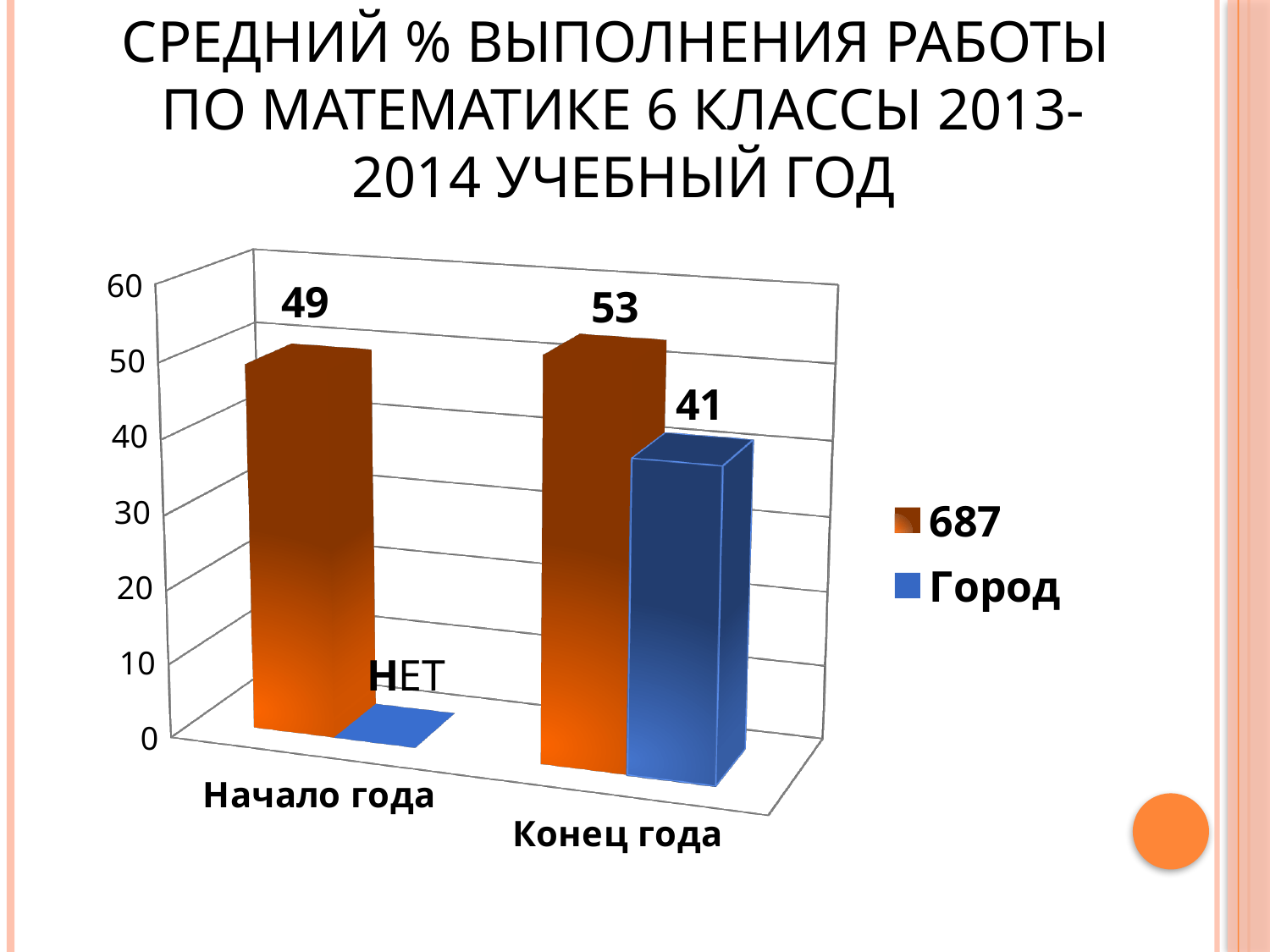
How many categories are shown on the x axis? 2 What is the value for series 687 at Конец года? 53 Which series is shown in blue in the legend? Город Which series has the higher value at Конец года? 687 Does the value for series 687 rise or fall from Начало года to Конец года? rise How many series does the legend list? 2 What is the value for series Город at Конец года? 41 By how much did the value for series 687 change from Начало года to Конец года? 4 What kind of chart is shown on the slide? bar chart What is the value for series 687 at Начало года? 49 What label is shown for series Город at Начало года? НЕТ What is the difference between the 687 and Город values at Конец года? 12